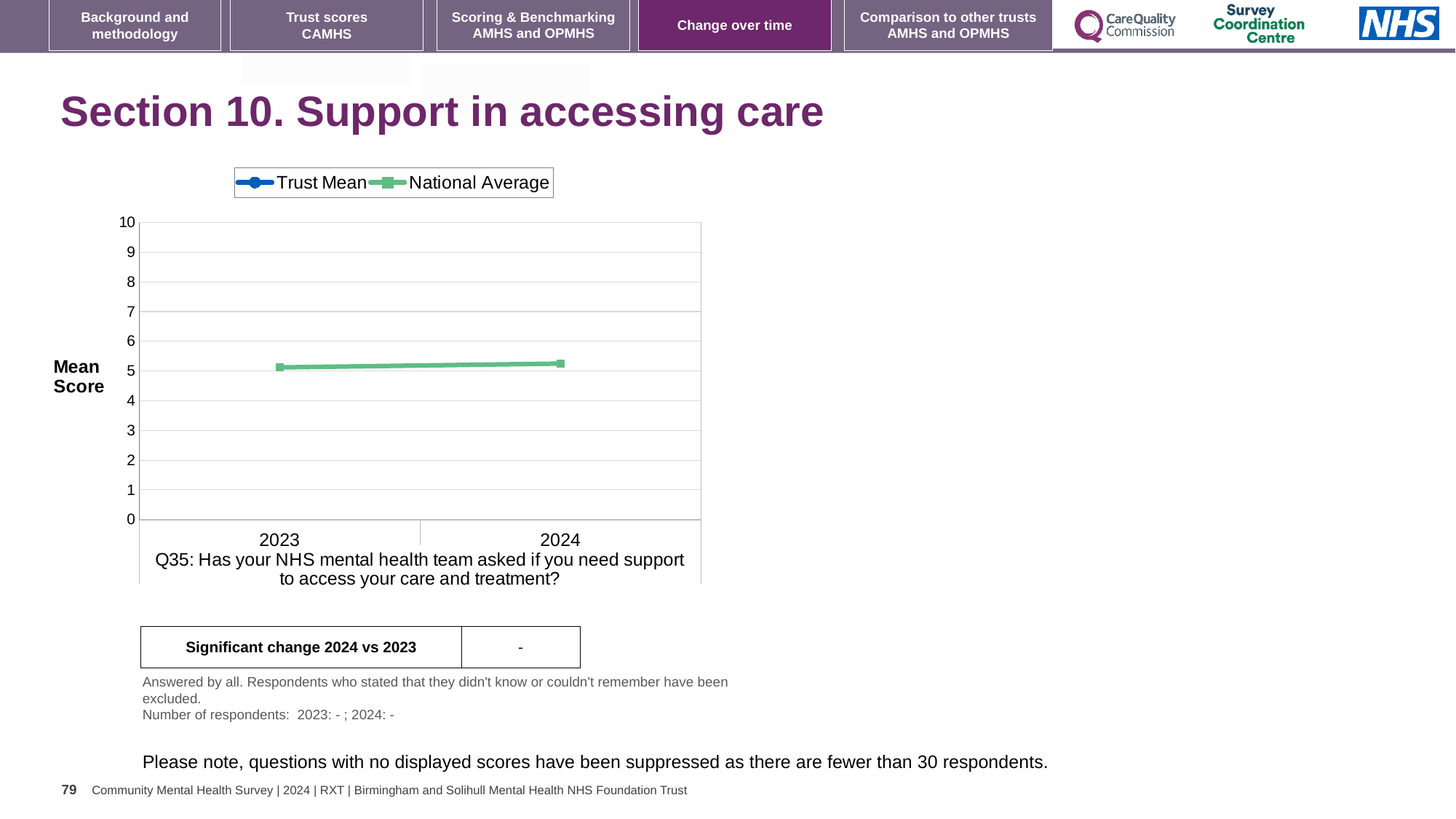
Is the National Average value for 2023 greater or less than 4? greater How many years are shown on the x axis? 2 Which series has no plotted line on the chart? Trust Mean What is the label on the y axis? Mean Score What kind of chart is shown on the slide? line chart How many series does the legend list? 2 Is the National Average value for 2024 greater or less than 6? less Does the National Average line rise or fall from 2023 to 2024? rise Is the National Average value for 2024 greater or less than 7? less Which two series are listed in the legend? Trust Mean and National Average